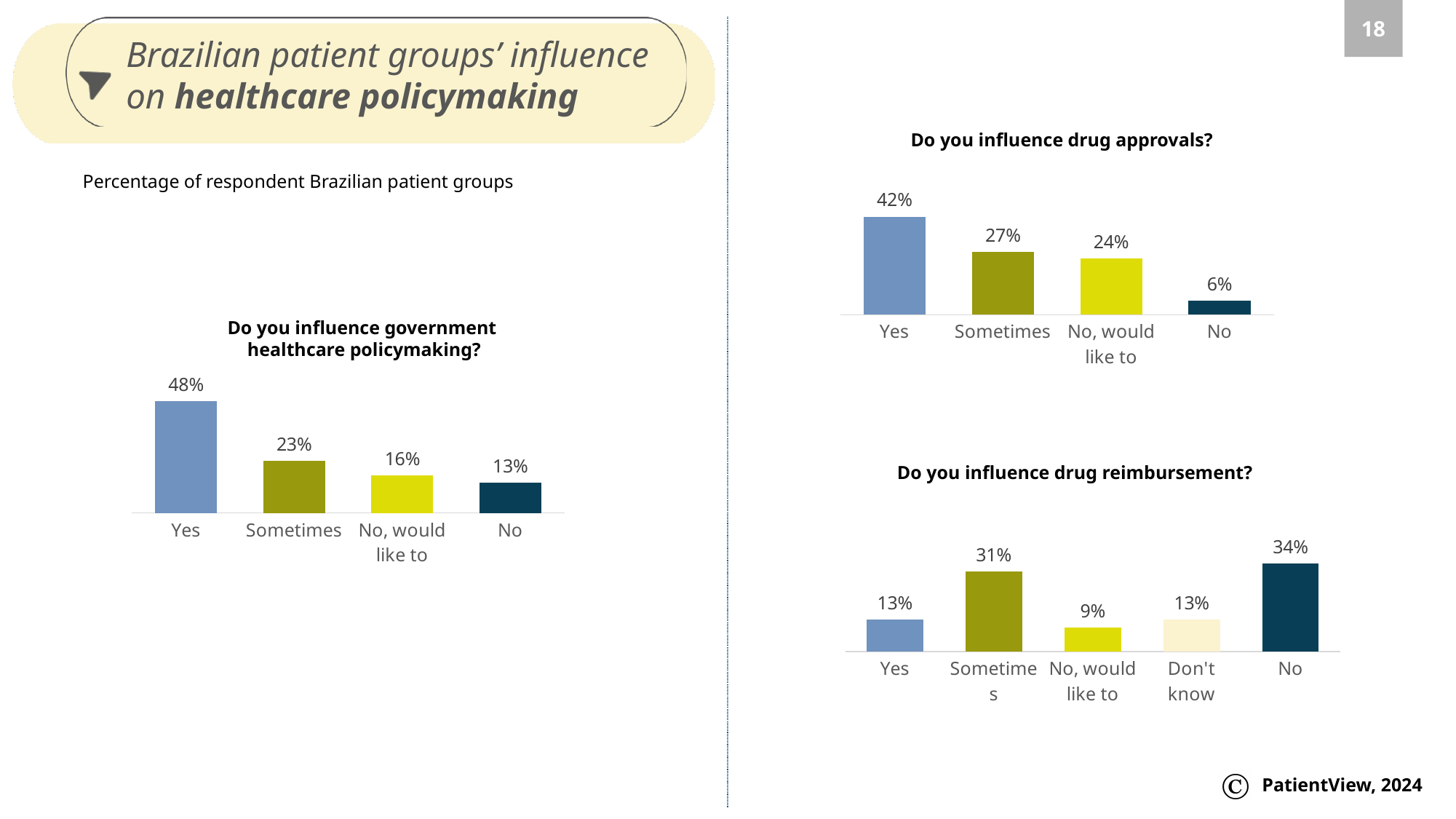
In the chart 'Do you influence government healthcare policymaking?', which category has the lowest value? No In the chart 'Do you influence drug reimbursement?', what percentage answered 'Sometimes'? 31% In the chart 'Do you influence government healthcare policymaking?', what percentage answered 'Yes'? 48% In the chart 'Do you influence drug reimbursement?', how many categories are shown? 5 What type of chart is 'Do you influence drug approvals?'? Bar chart In the chart 'Do you influence drug reimbursement?', which is larger, 'Yes' or 'No, would like to'? Yes In the chart 'Do you influence drug reimbursement?', what is the difference between 'No' and 'Don't know'? 21% In the chart 'Do you influence drug approvals?', what percentage answered 'No, would like to'? 24% In the chart 'Do you influence government healthcare policymaking?', what is the difference between 'Yes' and 'Sometimes'? 25% In the chart 'Do you influence drug approvals?', which category has the highest value? Yes In the chart 'Do you influence drug reimbursement?', which category has the highest value? No In the chart 'Do you influence drug approvals?', how many categories are shown? 4